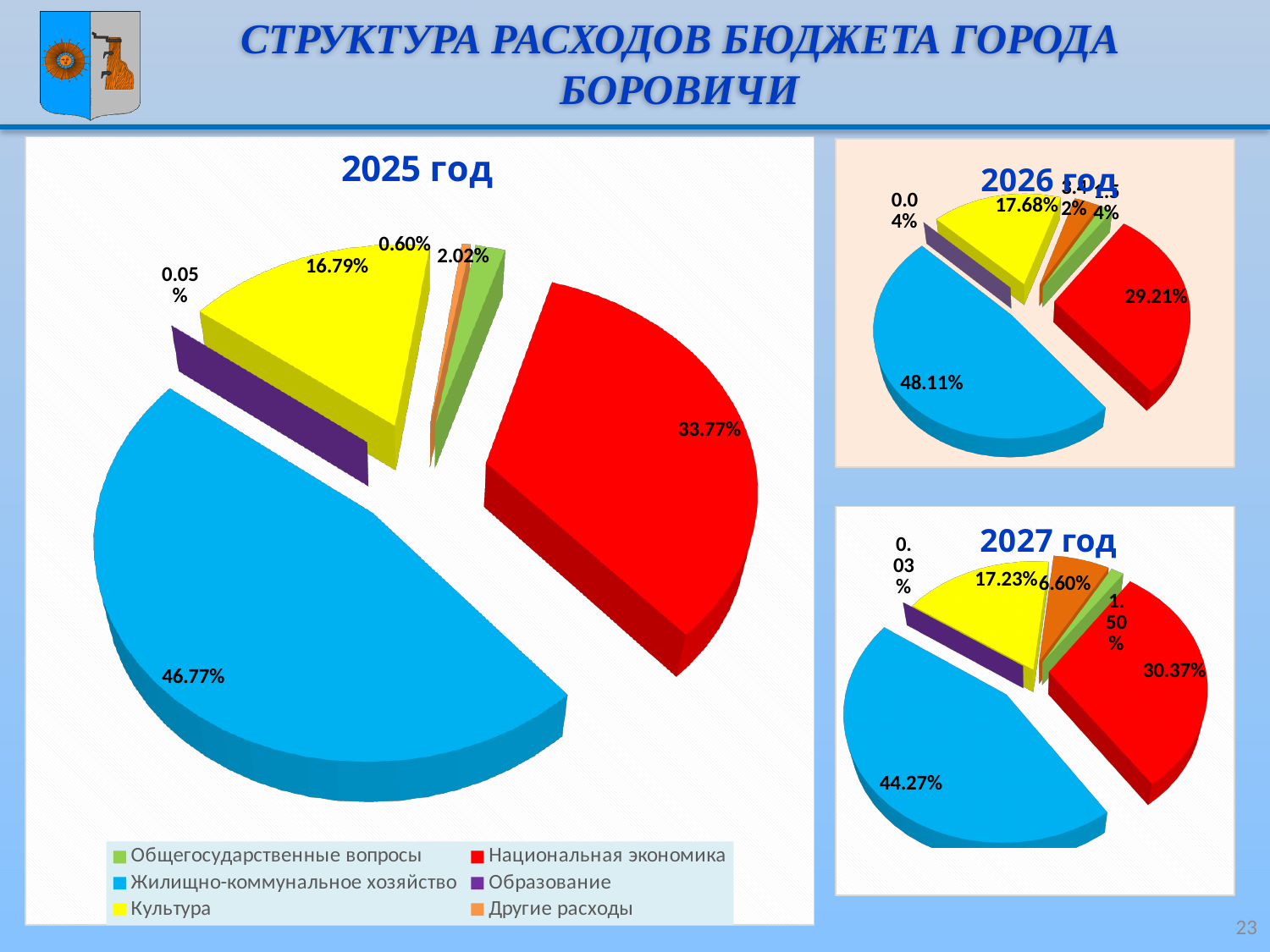
In the 2027 год pie chart, what share is shown for Другие расходы (orange slice)? 6.60% In the 2025 год pie chart, what share is shown for Культура (yellow slice)? 16.79% In the 2025 год pie chart, which category has the largest share? Жилищно-коммунальное хозяйство In the 2026 год pie chart, what share is shown for Жилищно-коммунальное хозяйство (blue slice)? 48.11% How many categories does the legend at the bottom of the slide list? 6 In the 2025 год pie chart, what is the difference between the shares of Жилищно-коммунальное хозяйство and Национальная экономика? 13.00% In the 2027 год pie chart, what share is shown for Национальная экономика (red slice)? 30.37% Which is larger in the 2026 год pie chart: the share of Национальная экономика or the share of Культура? Национальная экономика In the 2027 год pie chart, which category has the smallest share? Образование What type of chart is used for the 2025 год data? Pie chart In the 2025 год pie chart, what share is shown for Жилищно-коммунальное хозяйство (blue slice)? 46.77% In the 2025 год pie chart, what share is shown for Национальная экономика (red slice)? 33.77%